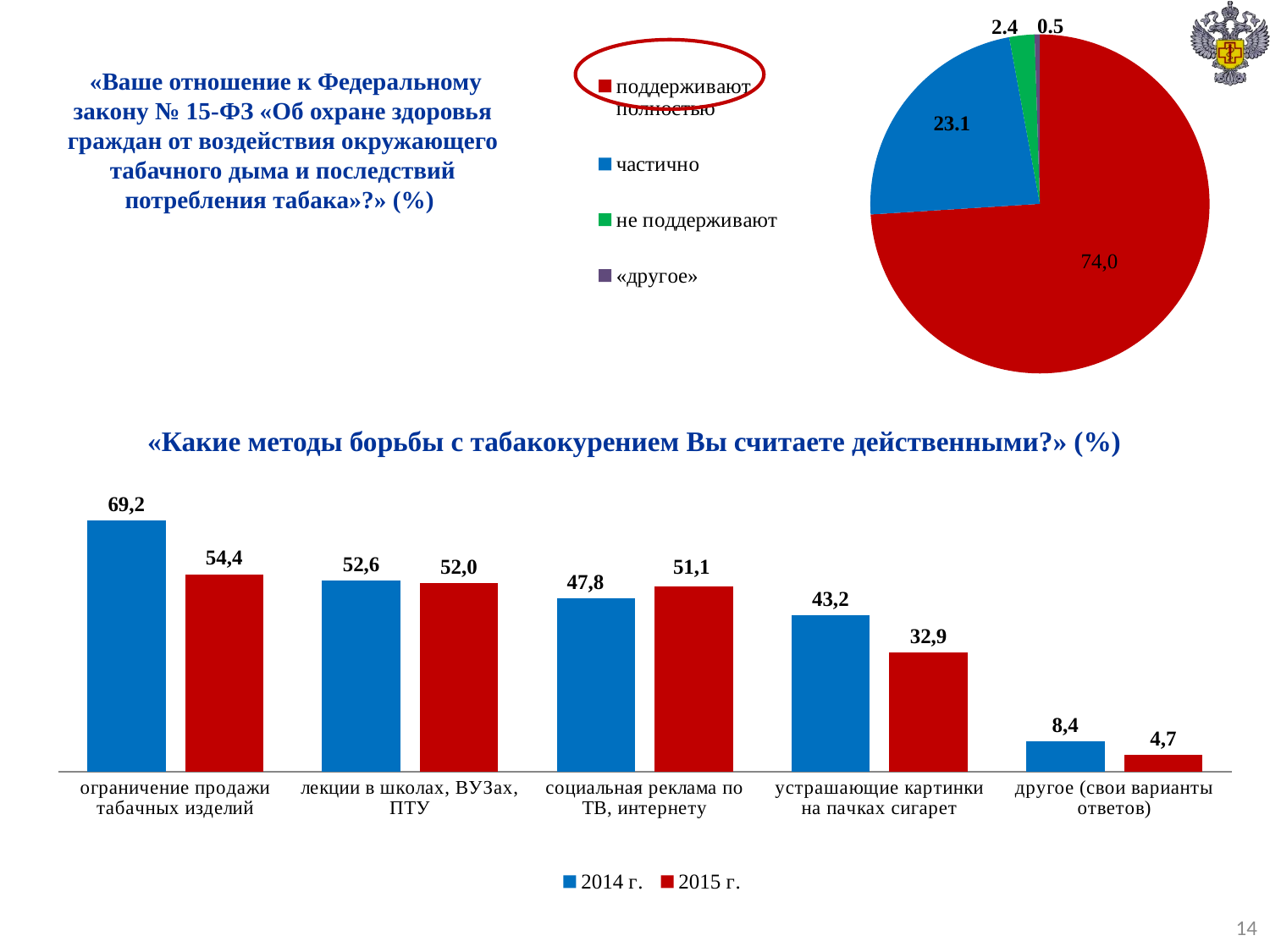
In the bar chart «Какие методы борьбы с табакокурением Вы считаете действенными?», which category has the highest 2015 г. value? ограничение продажи табачных изделий In the pie chart at the top of the slide, how many categories does the legend list? 4 In the bar chart «Какие методы борьбы с табакокурением Вы считаете действенными?», how many series does the legend list? 2 What kind of chart is the one at the top of the slide about attitude to Federal law № 15-ФЗ? pie chart In the bar chart «Какие методы борьбы с табакокурением Вы считаете действенными?», what is the 2014 г. value for «ограничение продажи табачных изделий»? 69,2 In the pie chart at the top of the slide, which category has the smallest slice? «другое» In the bar chart «Какие методы борьбы с табакокурением Вы считаете действенными?», which category has the lowest 2014 г. value? другое (свои варианты ответов) In the pie chart at the top of the slide, what share is shown for «поддерживают полностью»? 74,0 In the bar chart «Какие методы борьбы с табакокурением Вы считаете действенными?», for «социальная реклама по ТВ, интернету», which year has the larger value, 2014 г. or 2015 г.? 2015 г. In the pie chart at the top of the slide, what value is shown for «частично»? 23.1 In the bar chart «Какие методы борьбы с табакокурением Вы считаете действенными?», what is the difference between the 2014 г. and 2015 г. values for «ограничение продажи табачных изделий»? 14,8 In the bar chart «Какие методы борьбы с табакокурением Вы считаете действенными?», what is the 2015 г. value for «устрашающие картинки на пачках сигарет»? 32,9